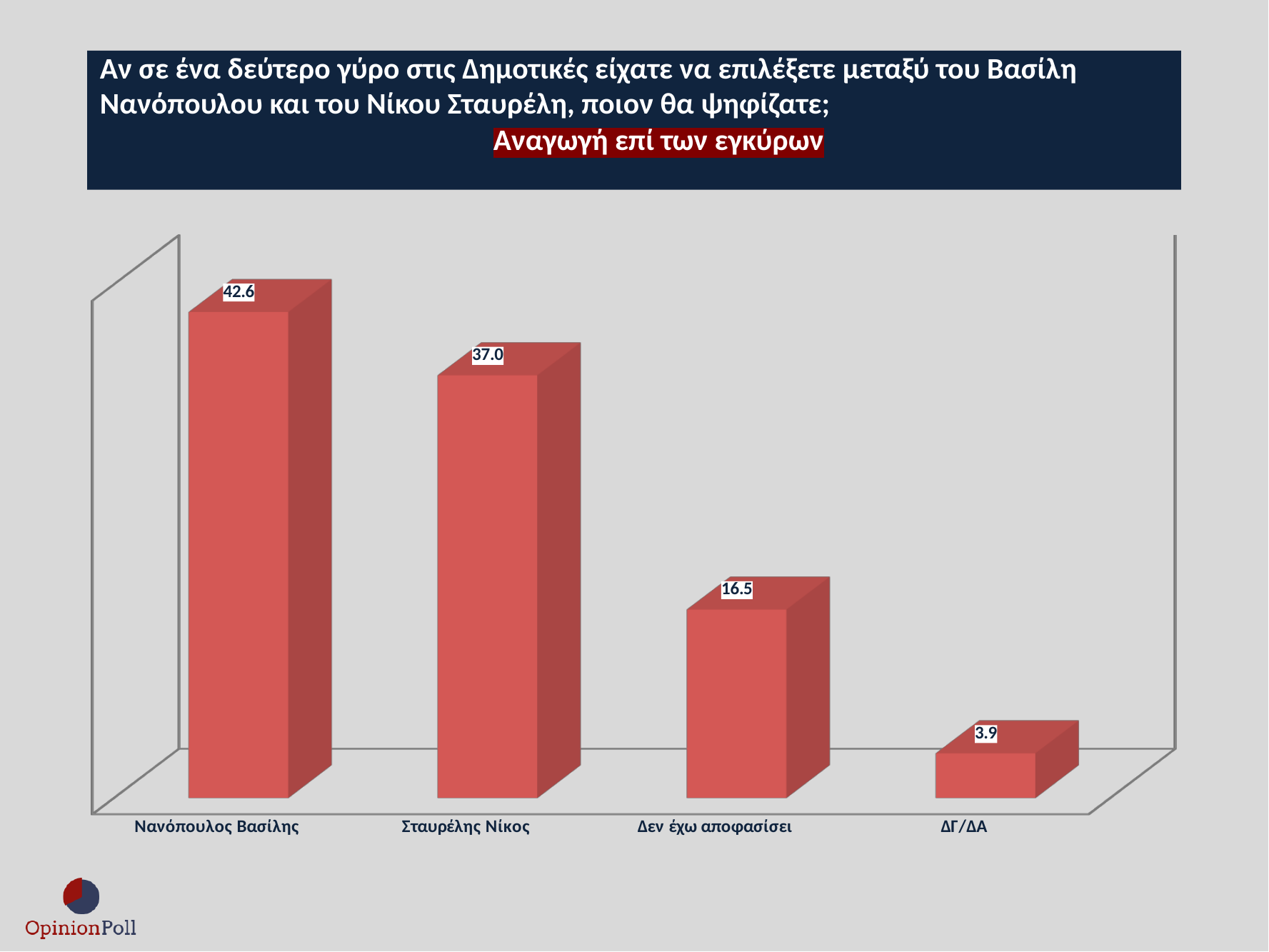
What kind of chart is shown on the slide? Bar chart What is the difference between the values for Νανόπουλος Βασίλης and Σταυρέλης Νίκος? 5.6 Do the values rise or fall from left to right along the x axis? Fall What is the value for Σταυρέλης Νίκος? 37.0 What is the value for Δεν έχω αποφασίσει? 16.5 Which category has the lowest value? ΔΓ/ΔΑ Which is larger, the value for Σταυρέλης Νίκος or the value for Δεν έχω αποφασίσει? Σταυρέλης Νίκος Which category has the highest value? Νανόπουλος Βασίλης What is the difference between the values for Δεν έχω αποφασίσει and ΔΓ/ΔΑ? 12.6 How many categories are shown in the chart? 4 What is the value for ΔΓ/ΔΑ? 3.9 What is the value for Νανόπουλος Βασίλης? 42.6